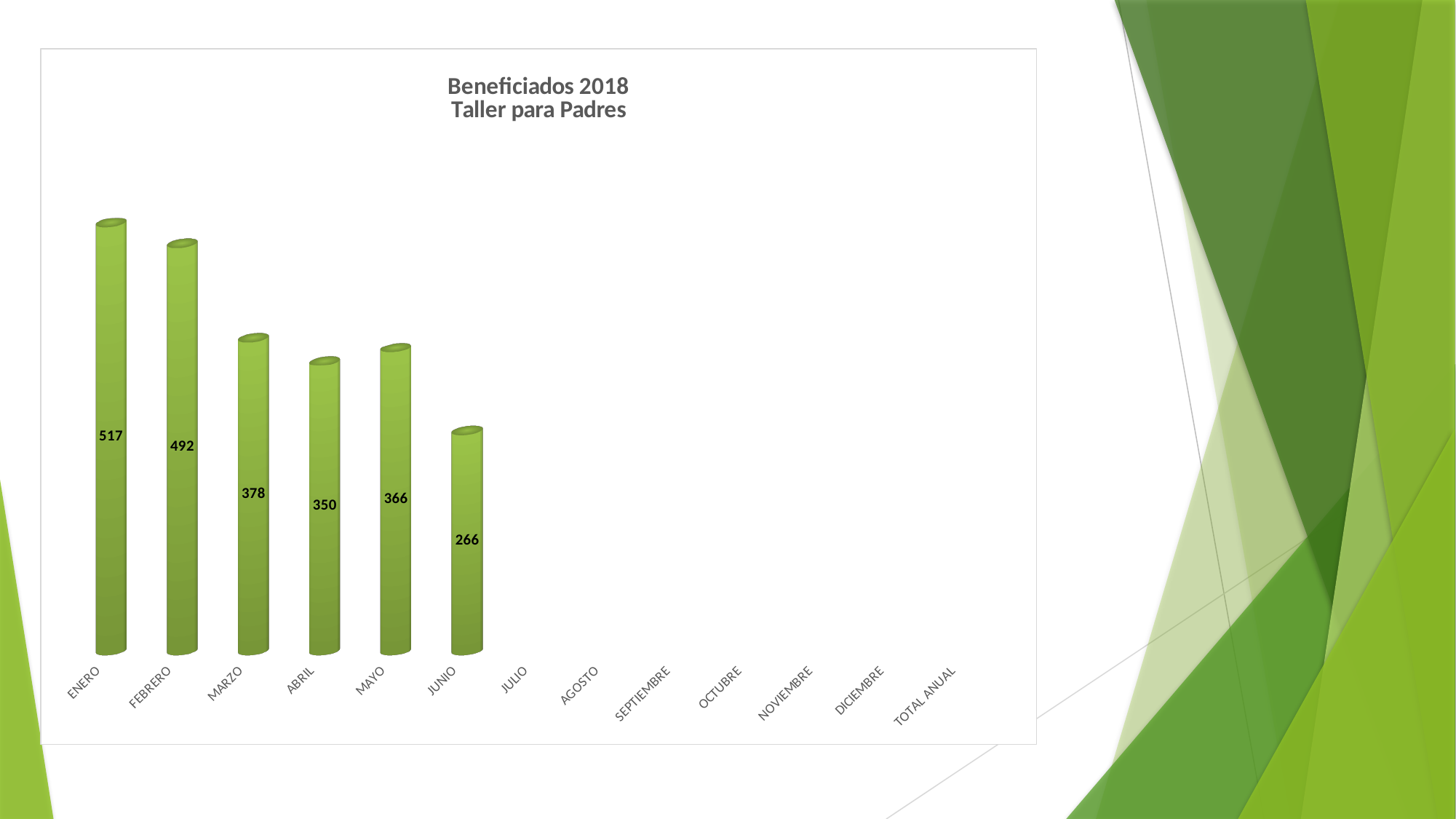
What is the title of the chart? Beneficiados 2018 Taller para Padres What is the value for ENERO? 517 What is the value for JUNIO? 266 What is the difference between the values for ENERO and FEBRERO? 25 How many bars with data are plotted on the chart? 6 What kind of chart is this? bar chart How many category labels are shown on the x axis? 13 Which is larger, the value for MARZO or the value for MAYO? MARZO Among the months with bars, which has the lowest value? JUNIO What is the value for ABRIL? 350 Which month has the highest value? ENERO What is the difference between the values for MAYO and JUNIO? 100